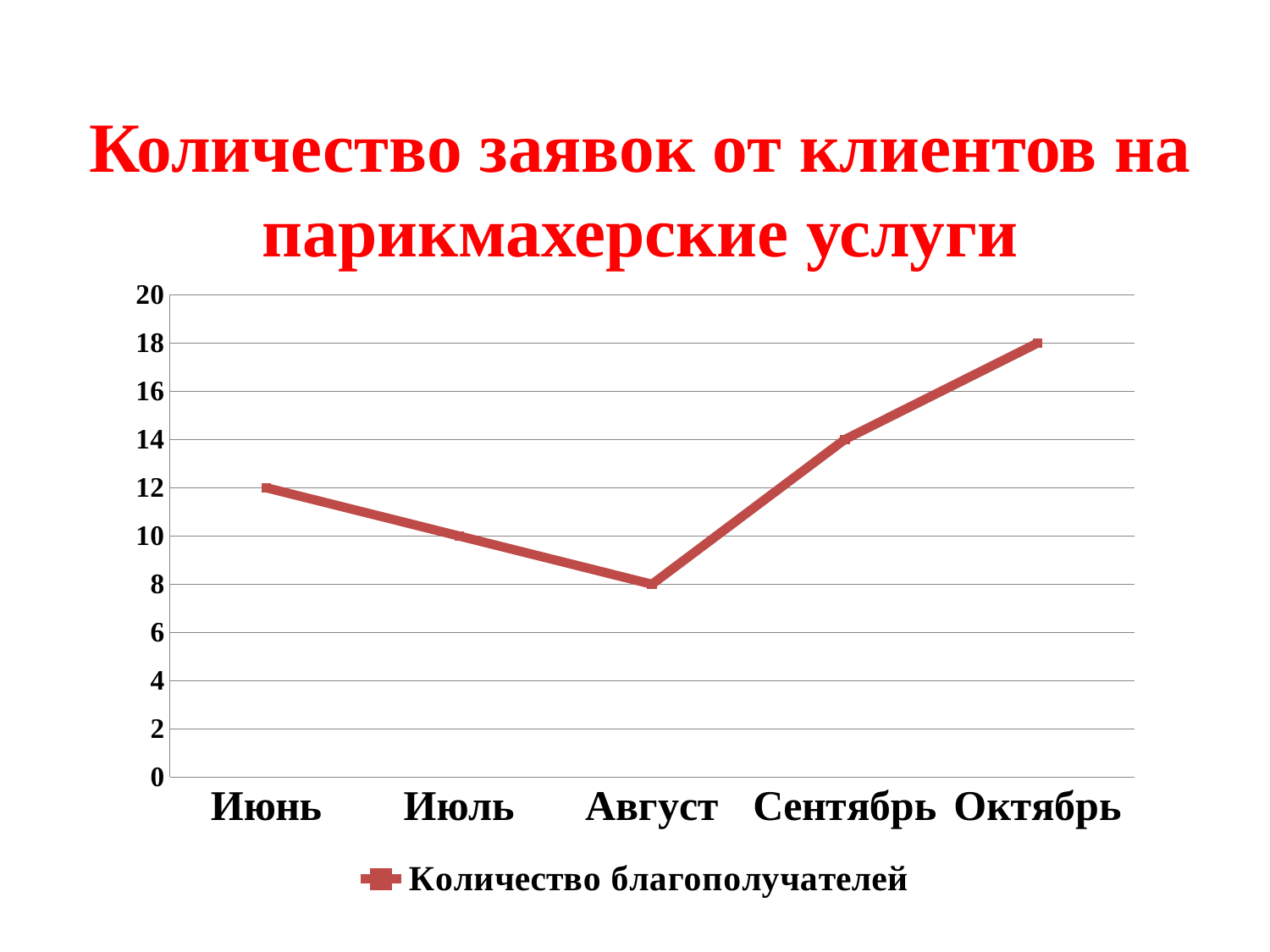
How many months are plotted on the x axis? 5 Which month has the highest value? Октябрь Which month has the lowest value? Август Is the value for Сентябрь greater or less than 10? greater Which is larger, the value for Июль or the value for Сентябрь? Сентябрь What kind of chart is shown on the slide? line chart What is the difference between the values for Октябрь and Август? 10 What is the value for Июнь? 12 How many series does the legend list? 1 What is the value for Октябрь? 18 What is the value for Август? 8 What is the name of the series shown in the legend? Количество благополучателей